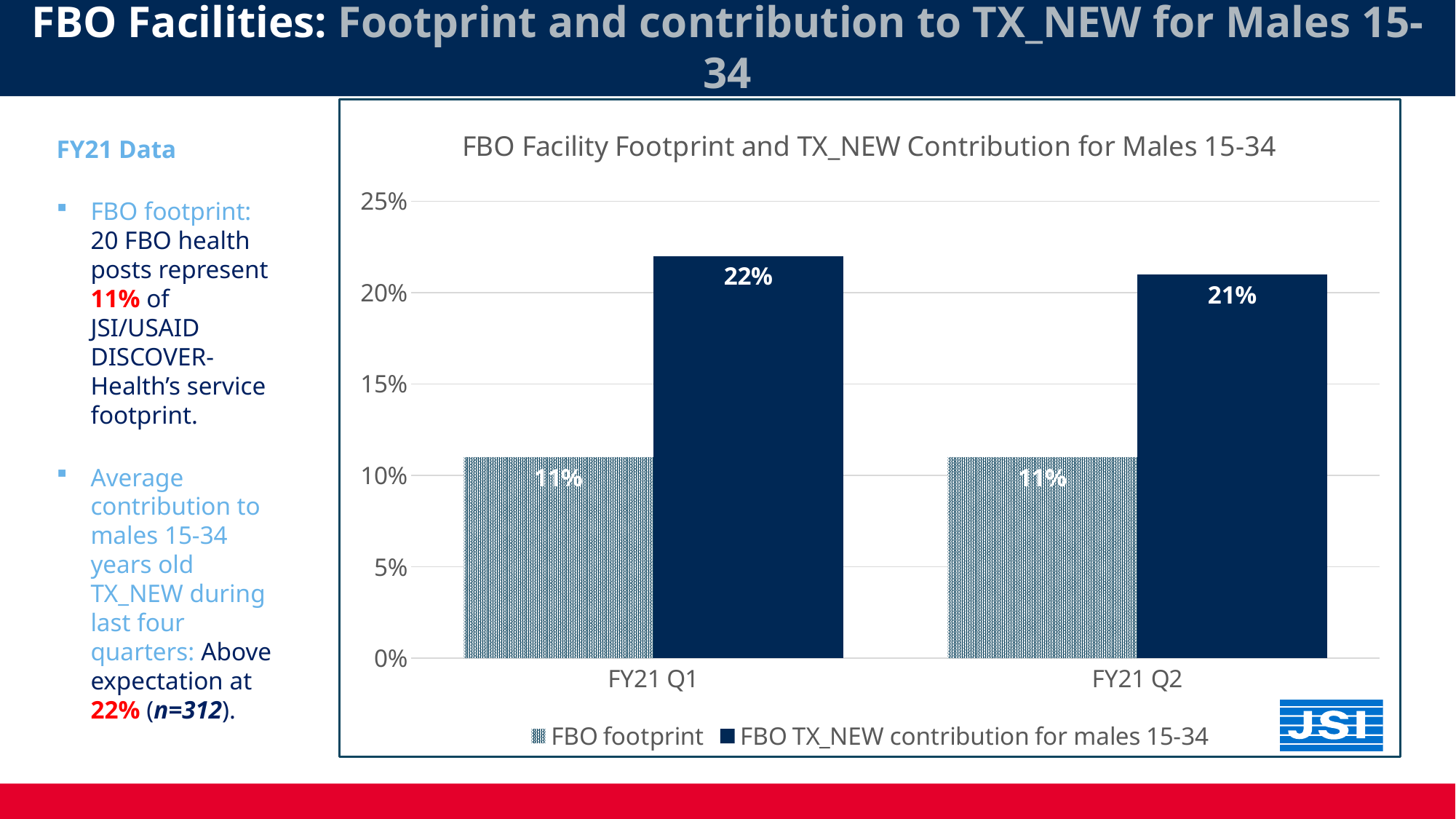
How many series does the chart legend list? 2 How many quarters are shown on the x axis of the chart? 2 What is the FBO footprint value in FY21 Q2? 11% What is the FBO TX_NEW contribution for males 15-34 in FY21 Q2? 21% In which quarter is the FBO TX_NEW contribution for males 15-34 highest? FY21 Q1 What is the FBO footprint value in FY21 Q1? 11% What is the difference between the FBO TX_NEW contribution and the FBO footprint in FY21 Q2? 10% What type of chart is shown on the slide? Bar chart What is the FBO TX_NEW contribution for males 15-34 in FY21 Q1? 22% Is the FBO TX_NEW contribution for males 15-34 in FY21 Q1 greater or less than 20%? greater What is the difference between the FBO TX_NEW contribution and the FBO footprint in FY21 Q1? 11% Which is larger in FY21 Q2: the FBO footprint or the FBO TX_NEW contribution for males 15-34? FBO TX_NEW contribution for males 15-34